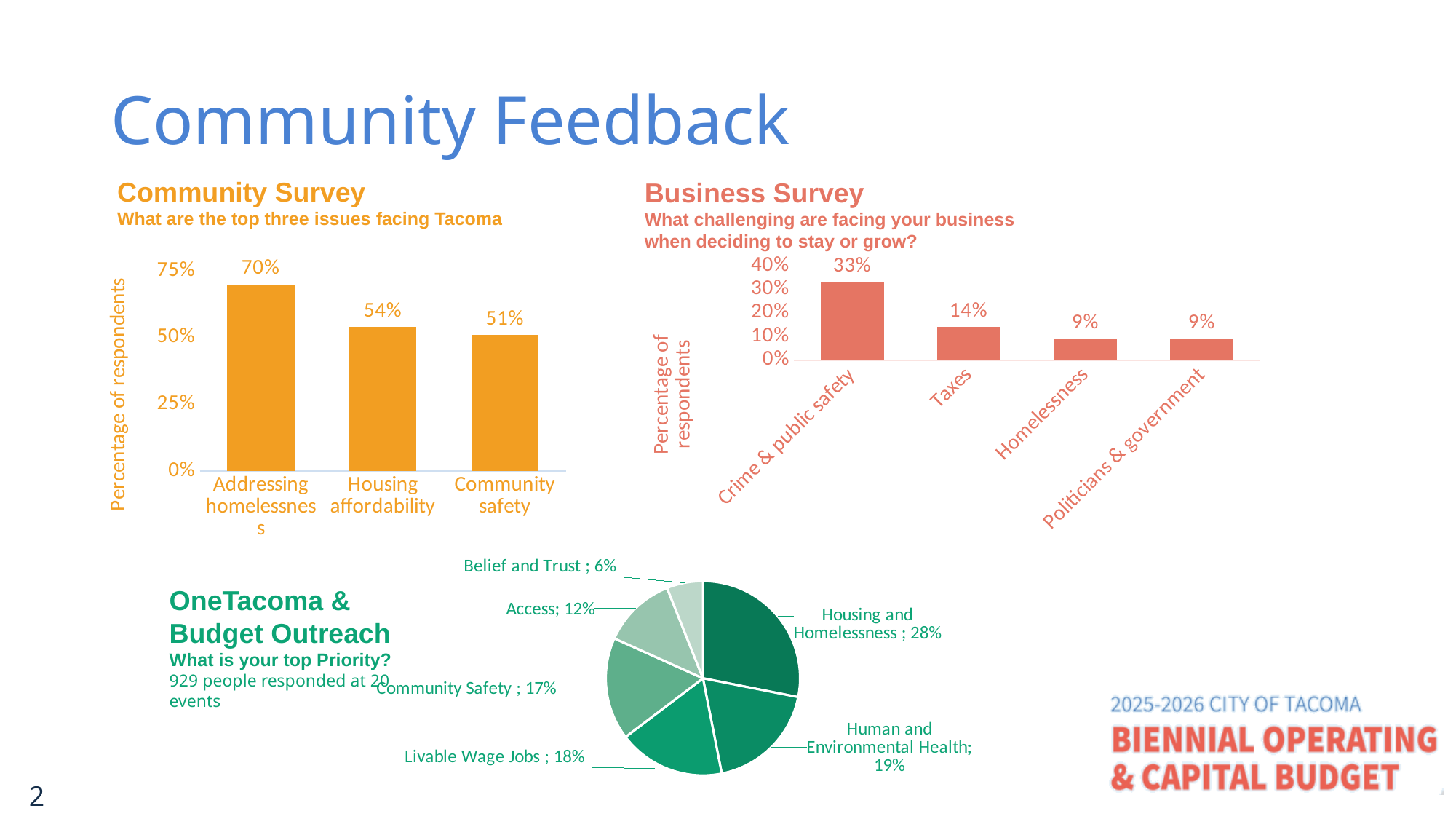
What kind of chart is the OneTacoma & Budget Outreach chart? pie chart How many categories are shown in the Community Survey chart? 3 In the Community Survey chart, which issue has the lowest percentage of respondents? Community safety In the OneTacoma & Budget Outreach pie chart, which priority has the smallest share? Belief and Trust How many slices does the OneTacoma & Budget Outreach pie chart have? 6 In the Community Survey chart, what percentage of respondents chose Addressing homelessness? 70% In the Business Survey chart, which challenge has the highest percentage? Crime & public safety In the OneTacoma & Budget Outreach pie chart, what share is Livable Wage Jobs? 18% In the Community Survey chart, what is the difference between Addressing homelessness and Housing affordability? 16% How many categories are shown in the Business Survey chart? 4 In the Business Survey chart, what percentage of respondents chose Taxes? 14% In the Business Survey chart, is the value for Crime & public safety larger or smaller than the value for Taxes? larger